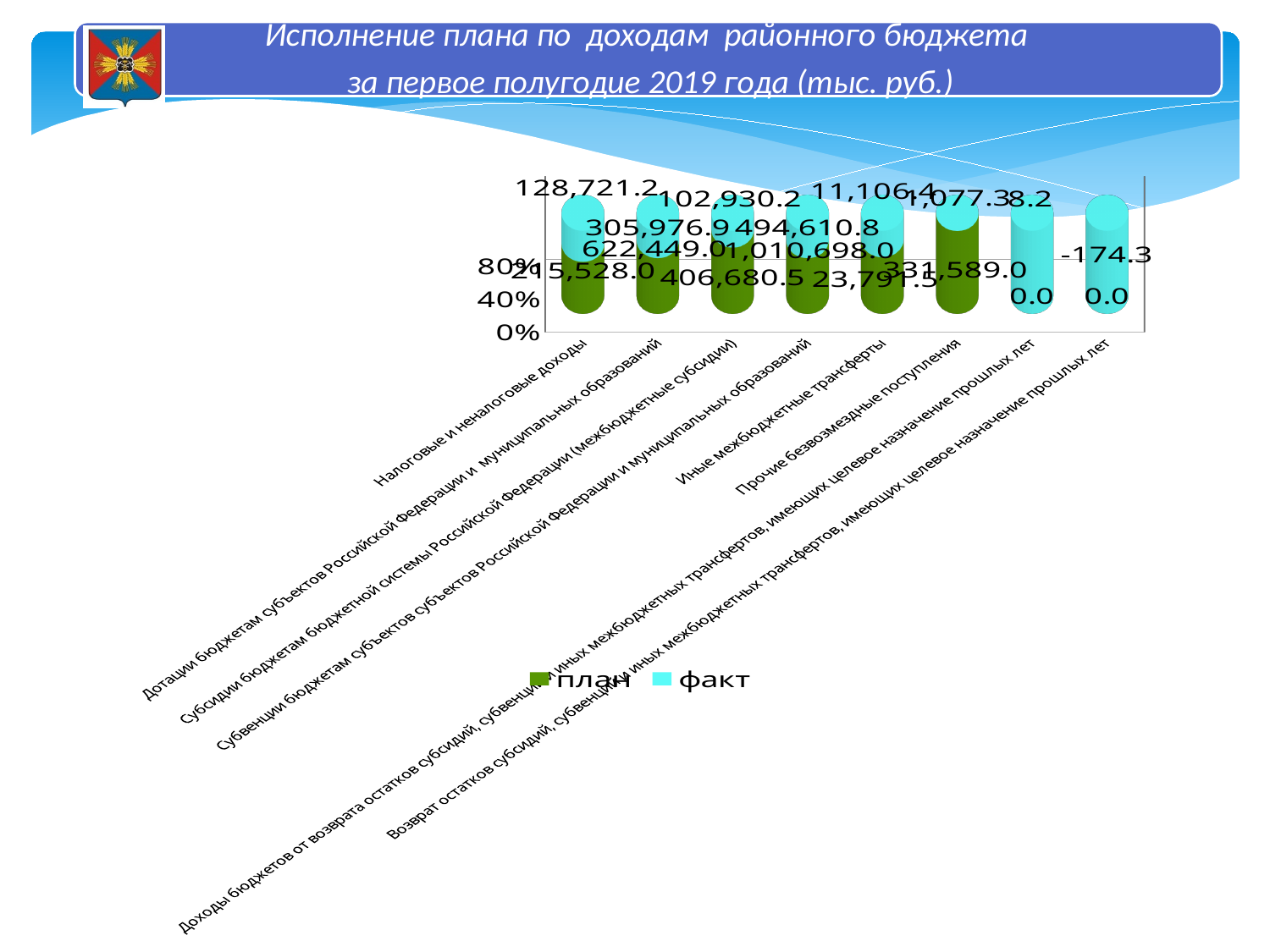
Which is larger for Субвенции бюджетам субъектов Российской Федерации и муниципальных образований, план or факт? план What is the факт value for Субсидии бюджетам бюджетной системы Российской Федерации (межбюджетные субсидии)? 102,930.2 What kind of chart is shown on the slide? bar chart What is the план value for Субвенции бюджетам субъектов Российской Федерации и муниципальных образований? 1,010,698.0 Which category has the lowest факт value? Возврат остатков субсидий, субвенций и иных межбюджетных трансфертов, имеющих целевое назначение прошлых лет What are the two series named in the legend? план and факт What is the факт value for Возврат остатков субсидий, субвенций и иных межбюджетных трансфертов, имеющих целевое назначение прошлых лет? -174.3 What is the difference between план and факт for Субсидии бюджетам бюджетной системы Российской Федерации (межбюджетные субсидии)? 303,750.3 What is the факт value for Иные межбюджетные трансферты? 11,106.4 How many categories are shown on the x axis? 8 How many series does the legend list? 2 What is the факт value for Налоговые и неналоговые доходы? 128,721.2